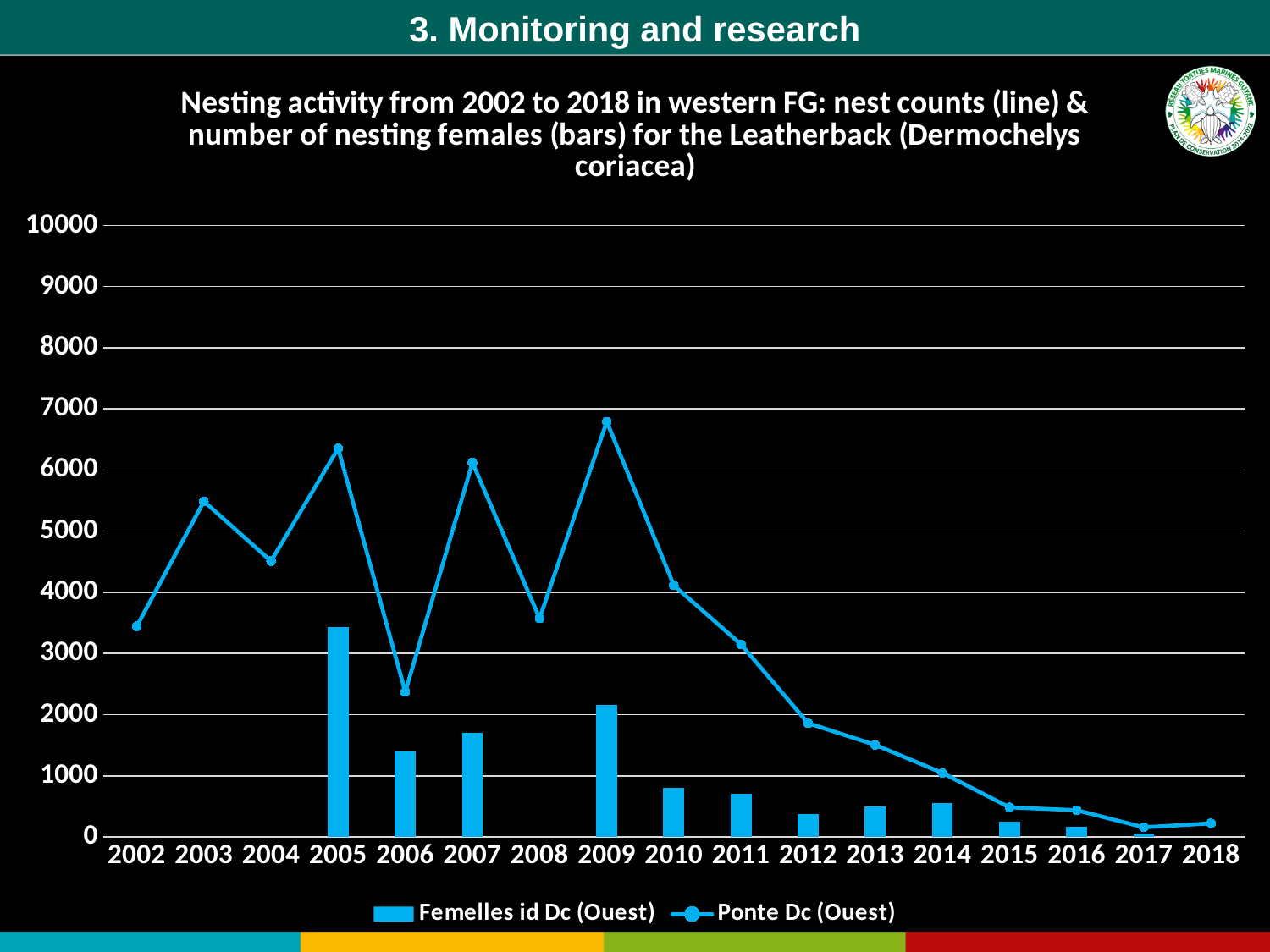
How many years are shown along the x axis? 17 In which year does the Ponte Dc (Ouest) line reach its highest value? 2009 Is the Femelles id Dc (Ouest) value for 2005 greater or less than 3000? greater In which year does the Ponte Dc (Ouest) line reach its lowest value? 2017 What kind of chart is shown on the slide? Combined bar and line chart Does the Ponte Dc (Ouest) line rise or fall from 2009 to 2018? fall In which year is the Femelles id Dc (Ouest) bar the tallest? 2005 How many series does the legend list? 2 Which series is drawn as bars according to the legend? Femelles id Dc (Ouest) Is the Ponte Dc (Ouest) value for 2009 greater or less than 6000? greater Which year has the higher Ponte Dc (Ouest) value, 2003 or 2004? 2003 Is the Ponte Dc (Ouest) value for 2006 greater or less than 3000? less